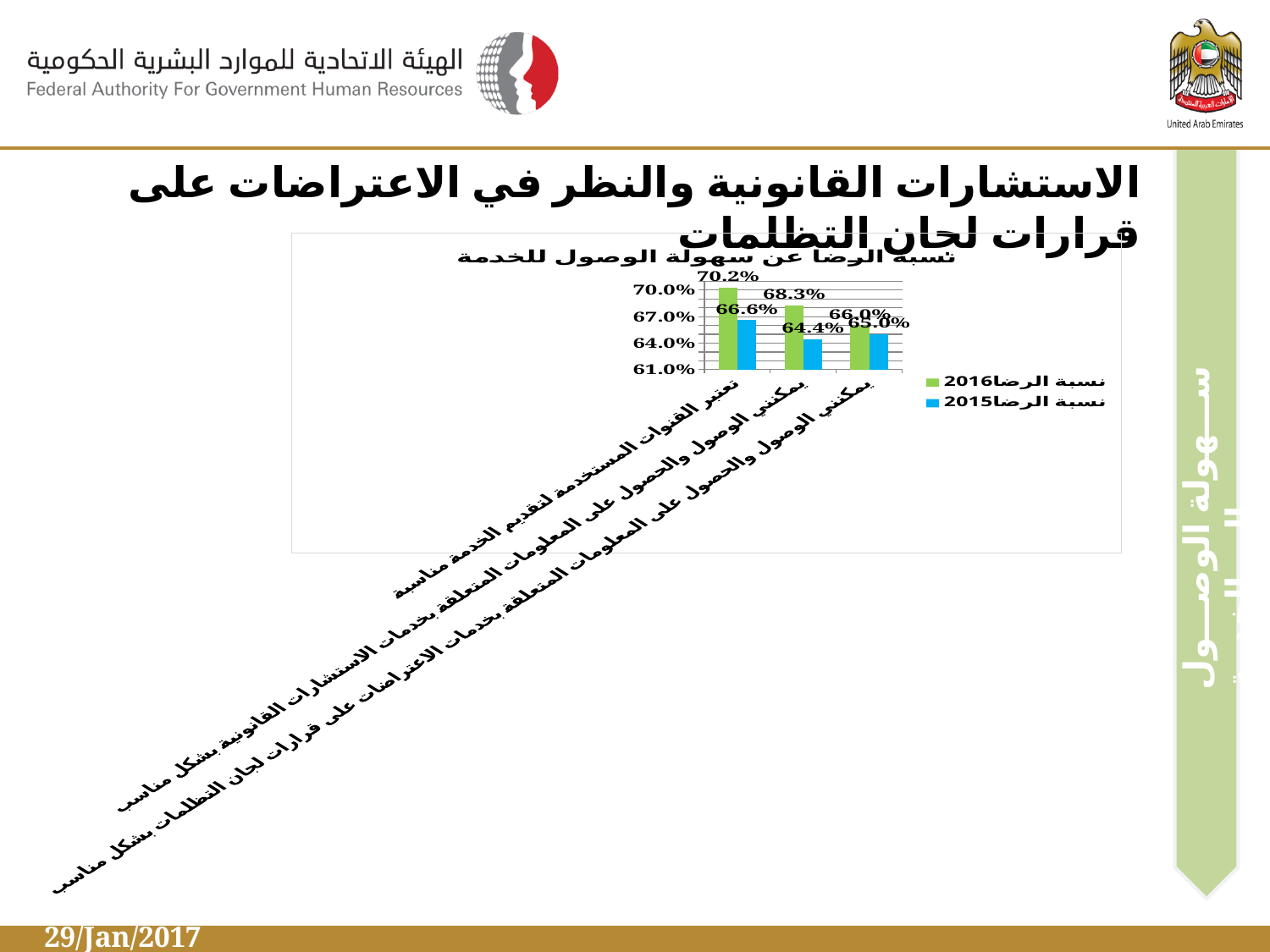
What is the 2015 satisfaction value (نسبة الرضا2015) for the middle category? 64.4% What is the title of the chart? نسبة الرضا عن سهولة الوصول للخدمة What kind of chart is shown on the slide? Bar chart What is the lowest value in the 2015 series (نسبة الرضا2015)? 64.4% How many series does the chart legend list? 2 Which category has the highest 2016 satisfaction value? تعتبر القنوات المستخدمة لتقديم الخدمة مناسبة (the first category, 70.2%) Do the 2016 satisfaction values rise or fall from left to right across the categories? Fall What is the 2016 satisfaction value (نسبة الرضا2016) for the third category on the right? 66.0% What is the 2016 satisfaction value (نسبة الرضا2016) for the first category on the left (تعتبر القنوات المستخدمة لتقديم الخدمة مناسبة)? 70.2% For the first category on the left, what is the difference between the 2016 value and the 2015 value? 3.6 percentage points How many categories are plotted on the x axis of the chart? 3 For the third category on the right, which is larger: the 2016 value or the 2015 value? 2016 (66.0%)